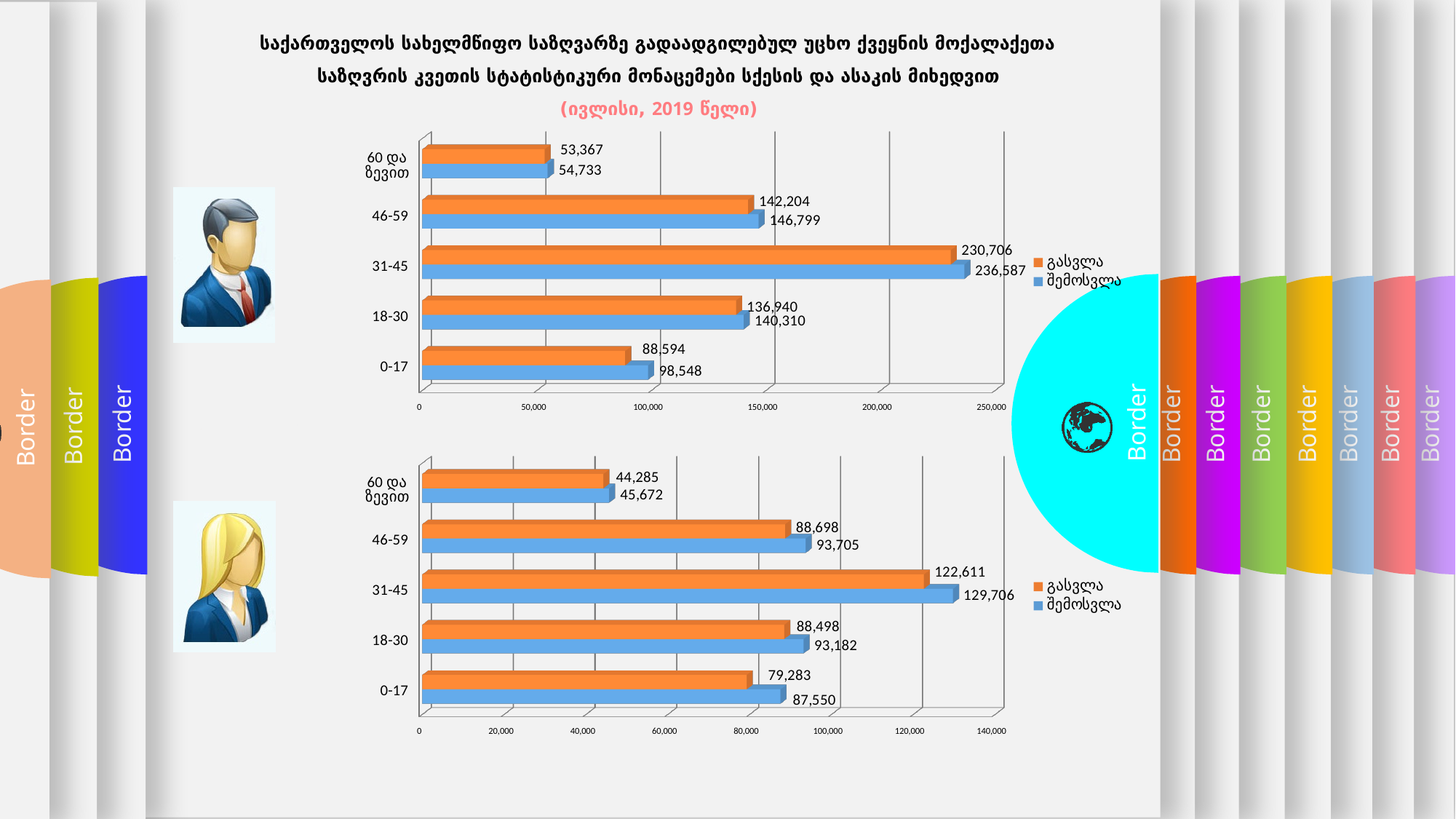
In the bottom chart, which age group has the lowest გასვლა value? 60 და ზევით What kind of chart is the top chart? Bar chart In the top chart, what is the გასვლა value for the 31-45 age group? 230,706 In the top chart, what is the შემოსვლა value for the 0-17 age group? 98,548 In the bottom chart, what is the შემოსვლა value for the 46-59 age group? 93,705 How many series does the legend of the bottom chart list? 2 In the bottom chart, which is larger for the 0-17 age group: გასვლა or შემოსვლა? შემოსვლა In the top chart, what is the difference between the შემოსვლა and გასვლა values for the 18-30 age group? 3,370 In the bottom chart, what is the გასვლა value for the 60 და ზევით age group? 44,285 In the bottom chart, what is the difference between the შემოსვლა and გასვლა values for the 31-45 age group? 7,095 In the top chart, which age group has the highest შემოსვლა value? 31-45 How many age groups are shown in the top chart? 5